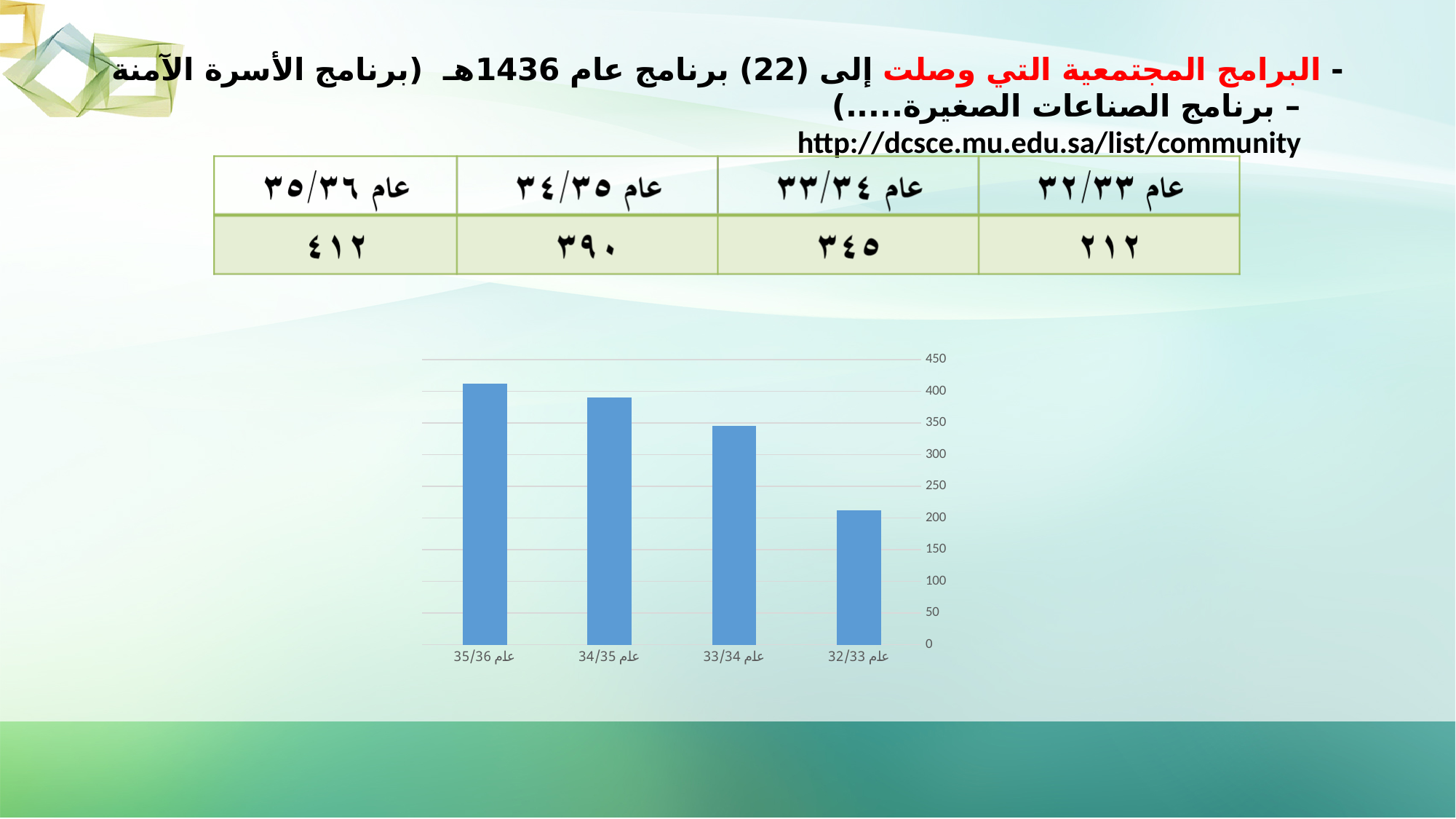
Is the value for عام 34/35 greater or less than 400? less Which is larger, the bar for عام 34/35 or the bar for عام 33/34? عام 34/35 Is the value for عام 33/34 greater or less than 300? greater Is the value for عام 32/33 greater or less than 250? less What is the highest value shown on the chart's vertical axis? 450 Reading the chart from left to right, do the bars rise or fall? fall What kind of chart is shown on the slide? bar chart Which category has the shortest bar in the chart? عام 32/33 According to the table above the chart, what is the value for عام 35/36? ٤١٢ How many bars does the chart have? 4 Which category has the tallest bar in the chart? عام 35/36